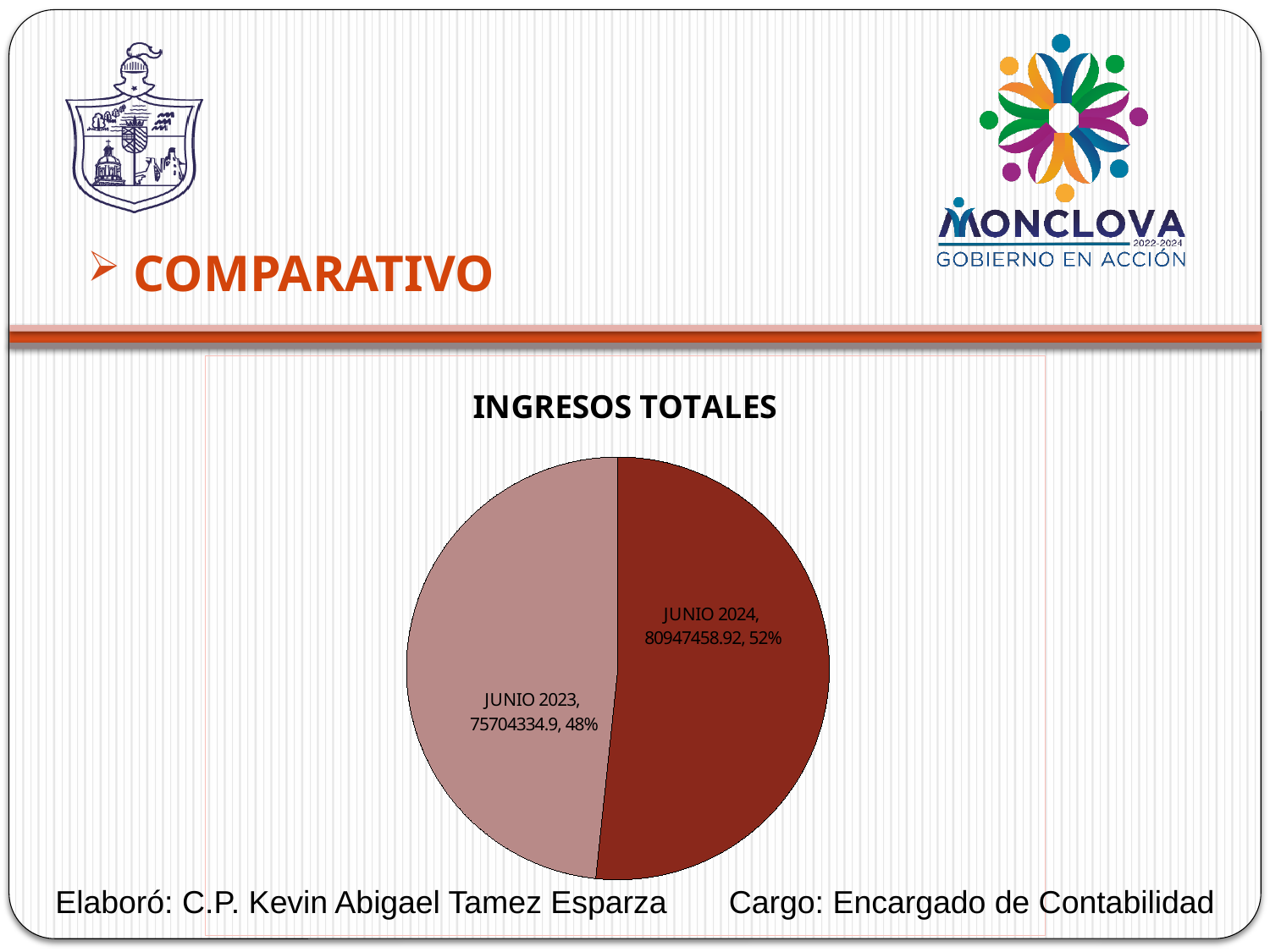
How many slices does the pie chart have? 2 Which slice is the largest? JUNIO 2024 What share of the pie does JUNIO 2023 represent? 48% What is the value for JUNIO 2023? 75704334.9 What share of the pie does JUNIO 2024 represent? 52% What is the title of the chart? INGRESOS TOTALES What is the total of the two slices in the pie chart? 156651793.82 Which slice is the smallest? JUNIO 2023 Which is larger, JUNIO 2023 or JUNIO 2024? JUNIO 2024 What is the value for JUNIO 2024? 80947458.92 What is the difference between the values for JUNIO 2024 and JUNIO 2023? 5243124.02 What type of chart is shown on the slide? pie chart